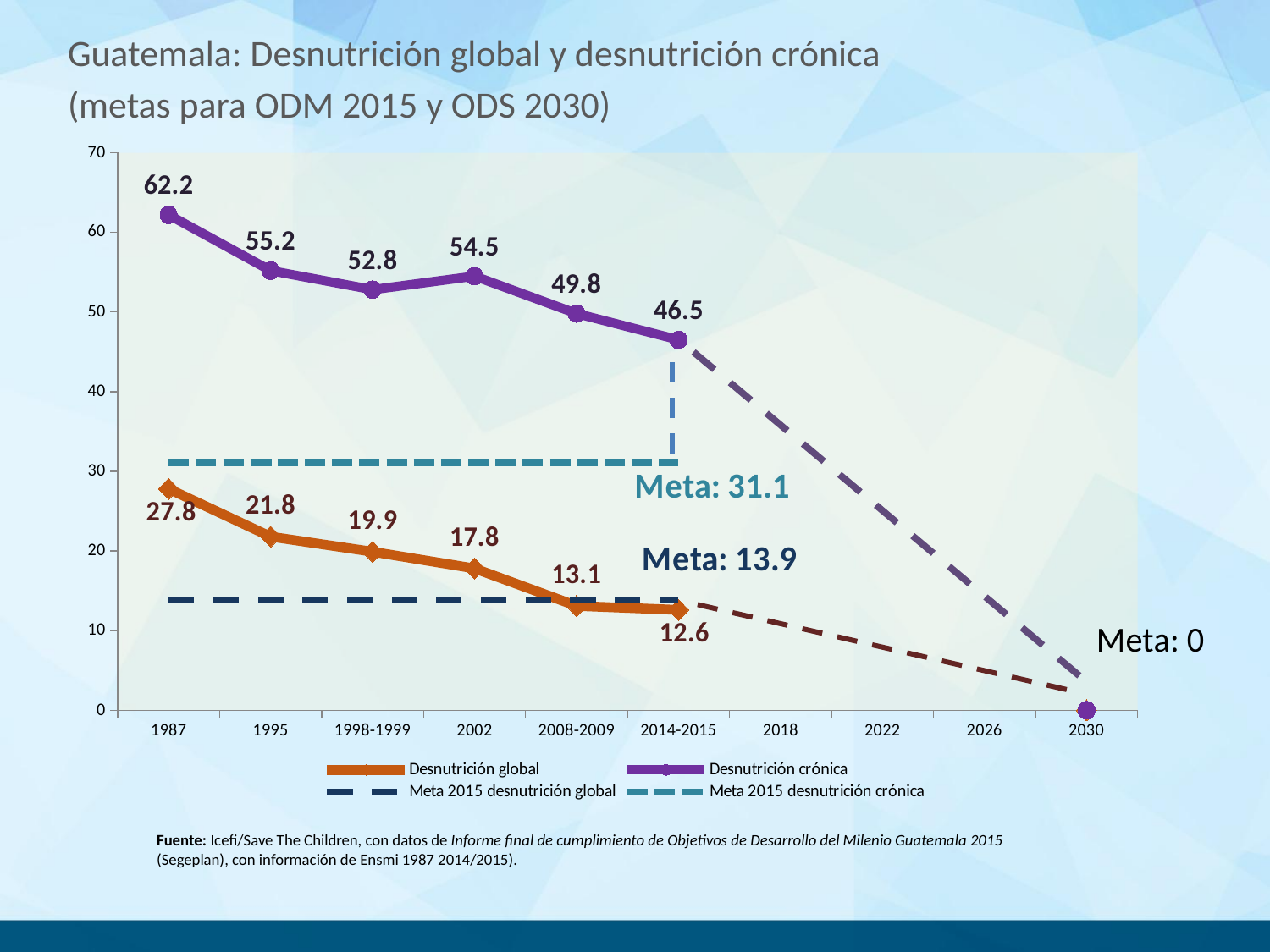
What is the value of Desnutrición crónica in 1987? 62.2 What is the value of Desnutrición crónica in 2002? 54.5 In which year is Desnutrición crónica highest? 1987 What kind of chart is shown on the slide? line chart What is the Meta 2015 value for desnutrición crónica shown on the chart? 31.1 Does Desnutrición global rise or fall from 1987 to 2014-2015? fall What is the value of Desnutrición global in 2014-2015? 12.6 Which is larger in 1995: Desnutrición crónica or Desnutrición global? Desnutrición crónica What is the difference between Desnutrición crónica in 1987 and in 2014-2015? 15.7 What is the value of Desnutrición global in 2008-2009? 13.1 How many series does the legend list? 4